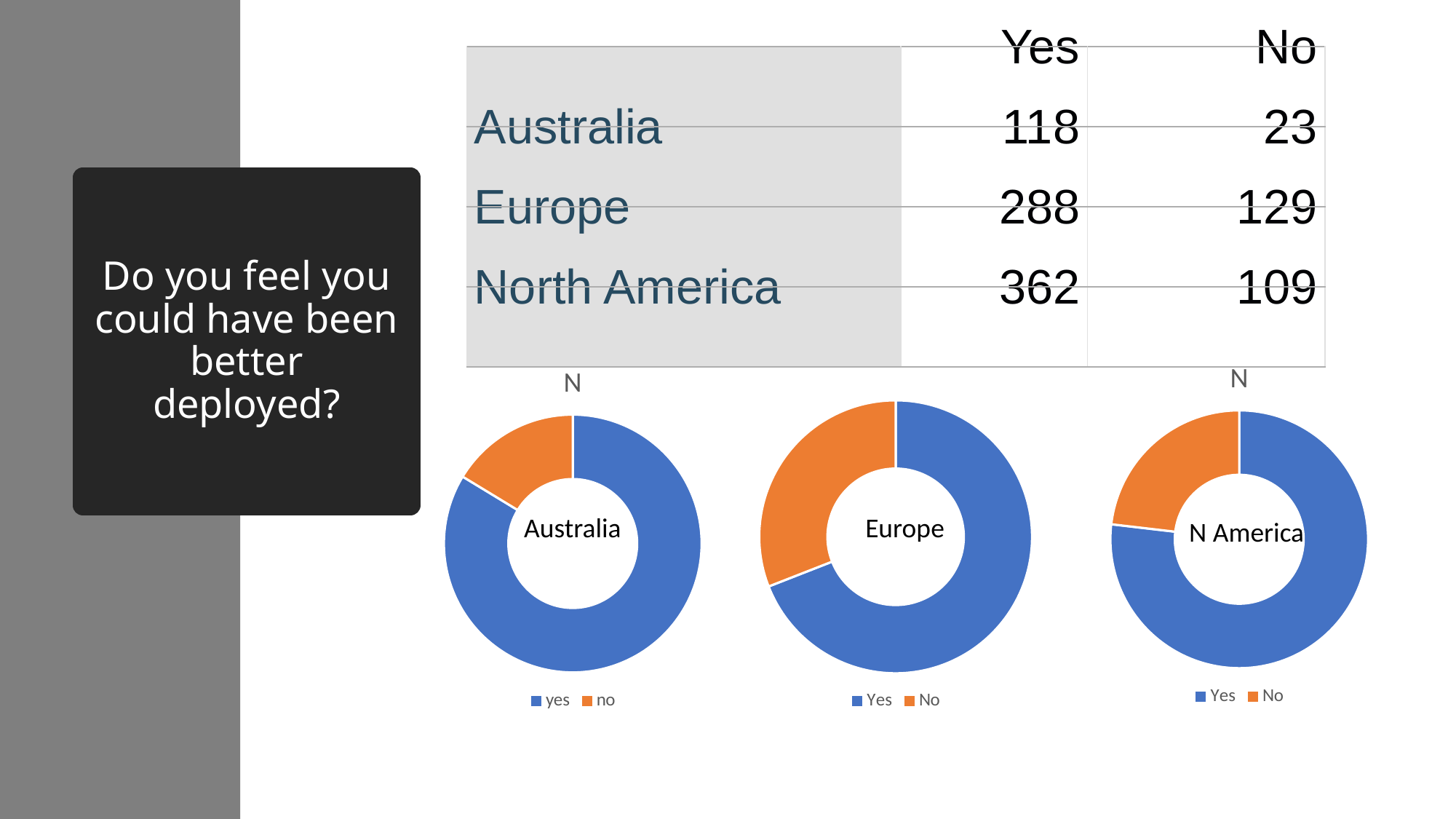
Using the table values, what is the difference between Yes and No responses for Europe? 159 In the N America chart, which slice is larger, Yes or No? Yes In the Europe chart, which slice is larger, Yes or No? Yes According to the table above the charts, how many Yes responses are there for Australia? 118 According to the table above the charts, how many No responses are there for Europe? 129 How many entries does the legend of the Europe chart list? 2 Using the table values, what is the total number of responses for Australia? 141 What colour represents Yes in the three doughnut charts? blue What kind of chart is the Australia chart? doughnut chart How many doughnut charts are shown on the slide? 3 According to the table above the charts, how many Yes responses are there for North America? 362 In the Australia chart, which slice is larger, yes or no? yes